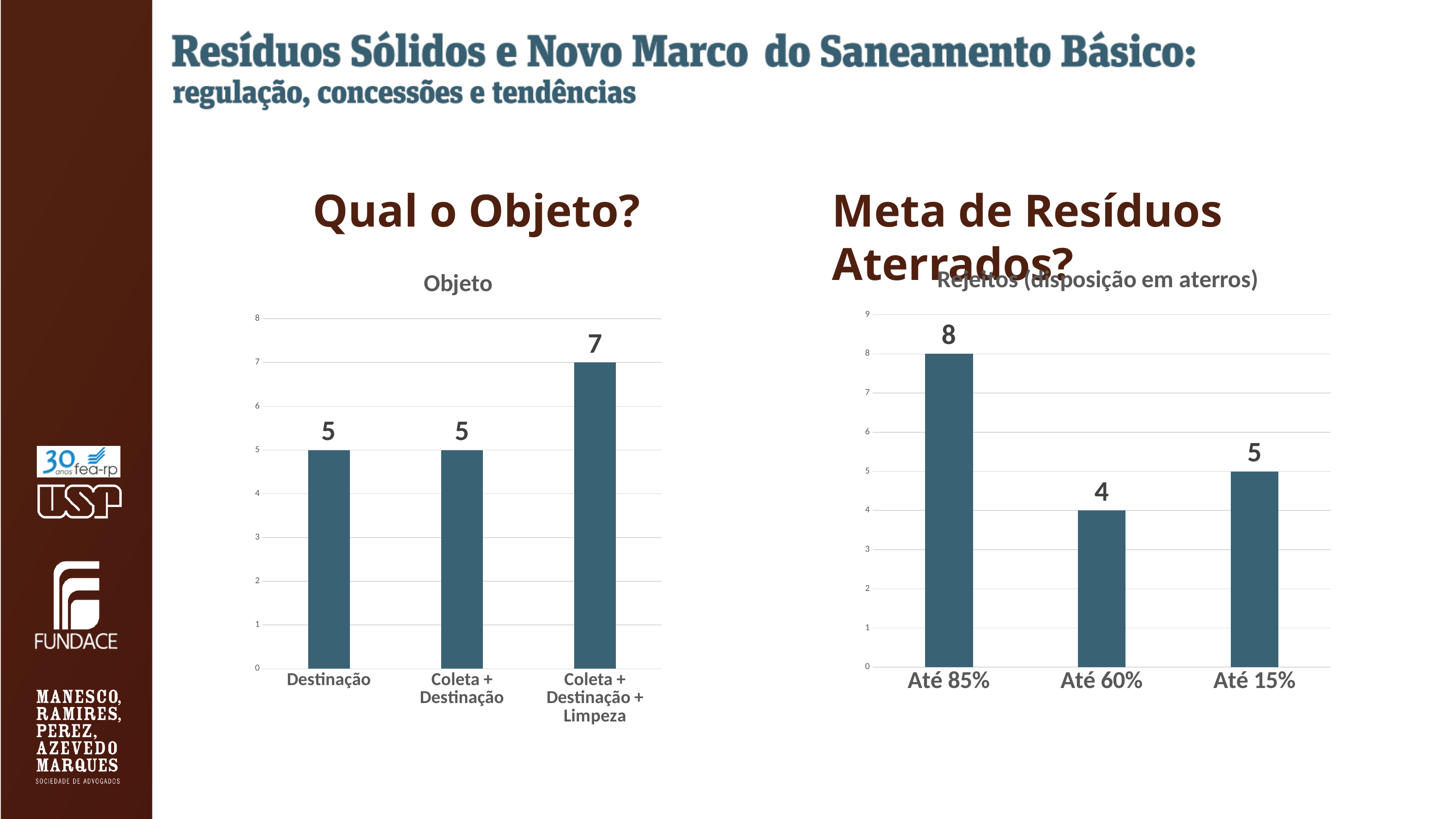
What kind of chart is the "Objeto" chart? Bar chart In the "Rejeitos (disposição em aterros)" chart, what is the difference between Até 85% and Até 60%? 4 In the "Objeto" chart, how many categories are shown? 3 In the "Rejeitos (disposição em aterros)" chart, what is the value for Até 85%? 8 In the "Rejeitos (disposição em aterros)" chart, what is the value for Até 15%? 5 In the "Rejeitos (disposição em aterros)" chart, what is the value for Até 60%? 4 In the "Objeto" chart, what is the value for Destinação? 5 In the "Rejeitos (disposição em aterros)" chart, which category has the lowest value? Até 60% In the "Objeto" chart, what is the difference between Coleta + Destinação + Limpeza and Destinação? 2 In the "Objeto" chart, which category has the highest value? Coleta + Destinação + Limpeza In the "Objeto" chart, what is the value for Coleta + Destinação + Limpeza? 7 In the "Rejeitos (disposição em aterros)" chart, which is larger, Até 85% or Até 15%? Até 85%